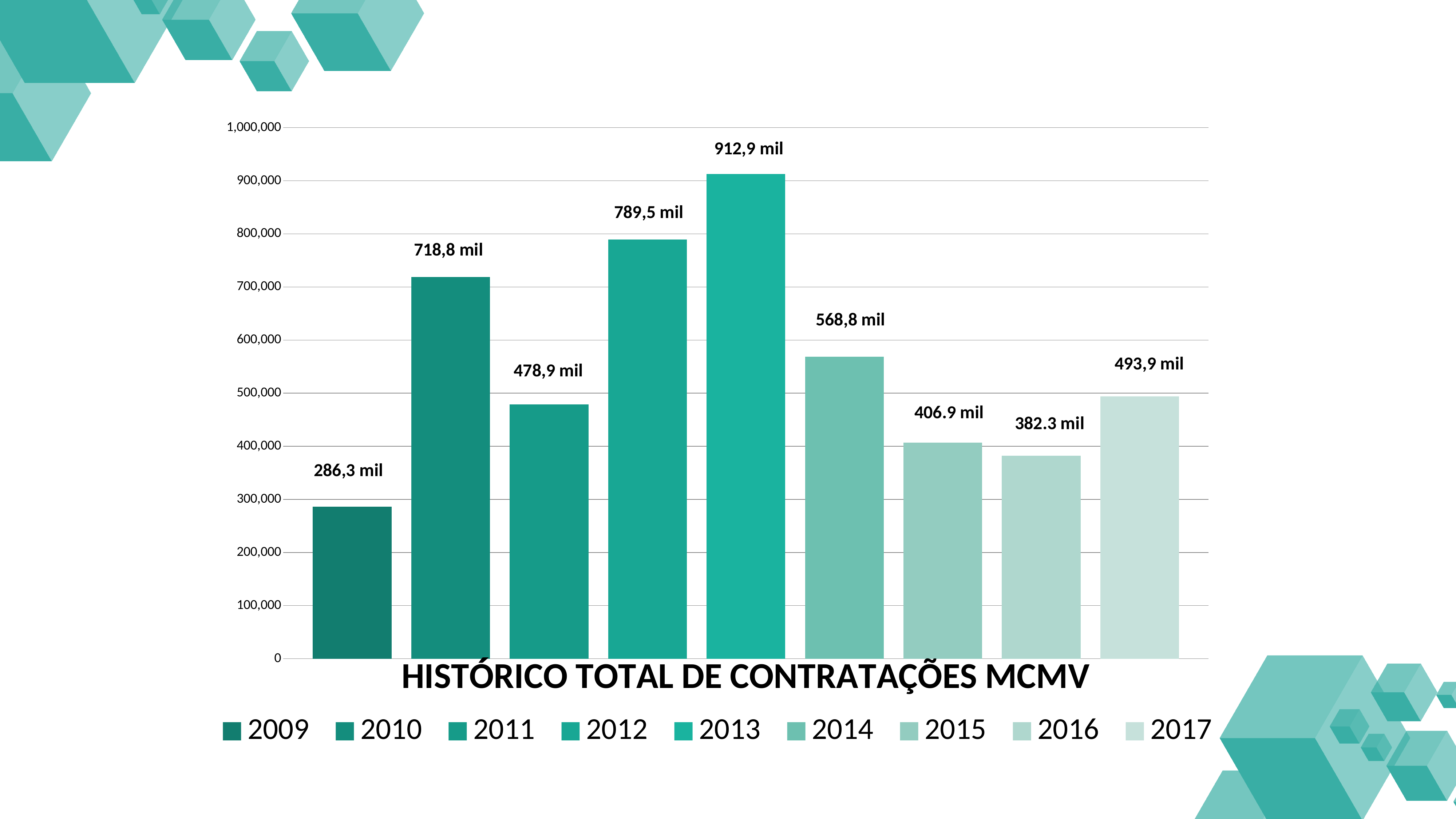
What is the difference between the values for 2013 and 2012? 123,4 mil What is the title of the chart? HISTÓRICO TOTAL DE CONTRATAÇÕES MCMV What type of chart is shown on the slide? Bar chart How many years are plotted in the chart? 9 What is the value shown for 2009? 286,3 mil What is the value shown for 2016? 382.3 mil Which is larger, the value for 2010 or the value for 2014? 2010 Which year has the highest value? 2013 Is the value for 2014 greater or less than 500,000? greater What is the value shown for 2013? 912,9 mil Do the values rise or fall from 2013 to 2016? Fall Which year has the lowest value? 2009